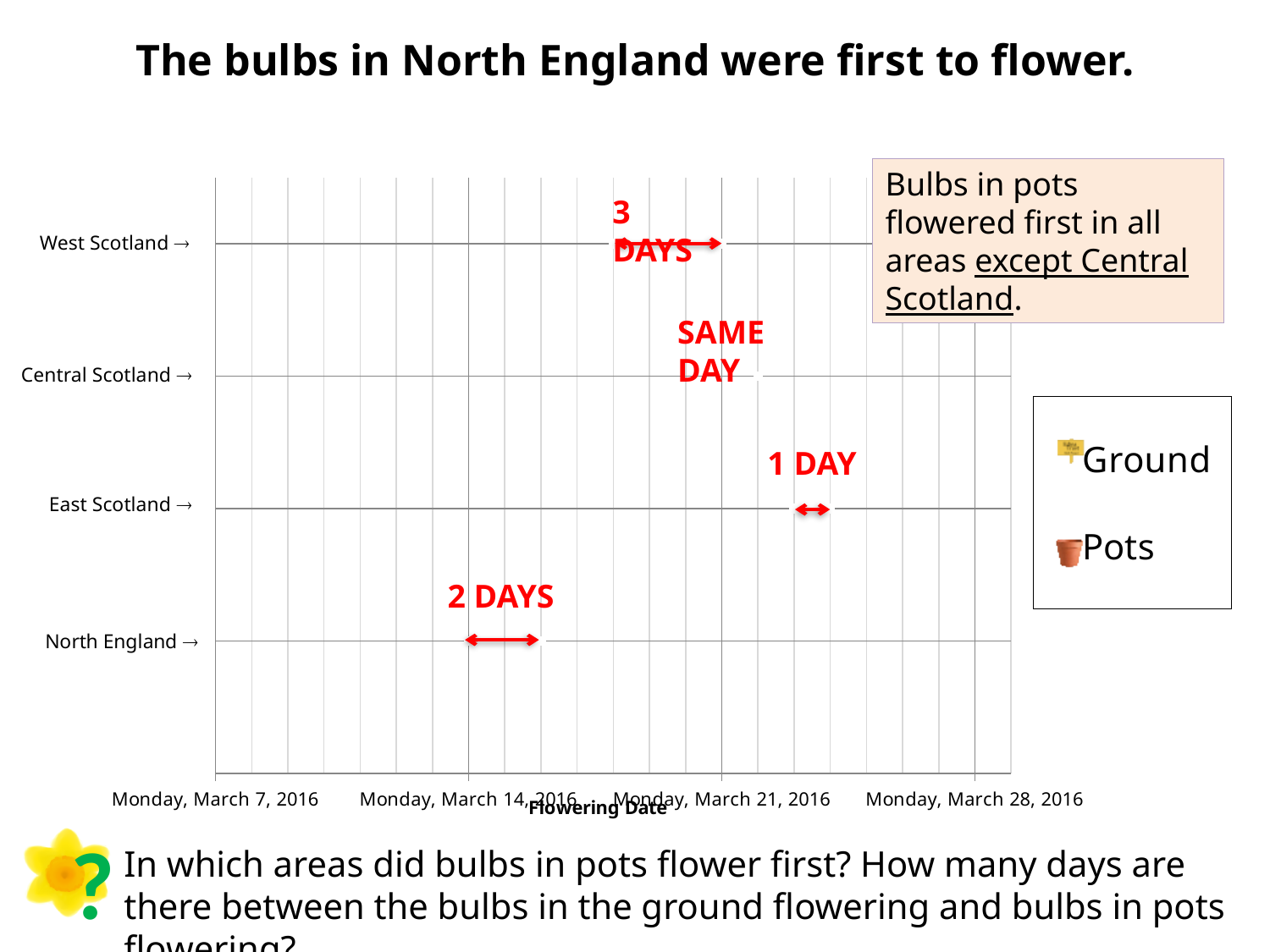
How many areas are listed on the vertical axis of the chart? 4 According to the annotation, how many days apart did the ground and pot bulbs flower in North England? 2 DAYS According to the annotation, how many days apart did the ground and pot bulbs flower in East Scotland? 1 DAY What are the two entries in the chart's legend? Ground and Pots Is the annotated flowering gap larger in North England or in East Scotland? North England What does the annotation say about the flowering gap between ground and pot bulbs in Central Scotland? SAME DAY How many more days is the annotated flowering gap in West Scotland than in North England? 1 day Which area has the largest annotated gap in days between ground and pot bulbs flowering? West Scotland According to the annotation, how many days apart did the ground and pot bulbs flower in West Scotland? 3 DAYS How many series does the chart's legend list? 2 Which area has the smallest annotated gap between ground and pot bulbs flowering? Central Scotland What is the label on the horizontal axis of the chart? Flowering Date